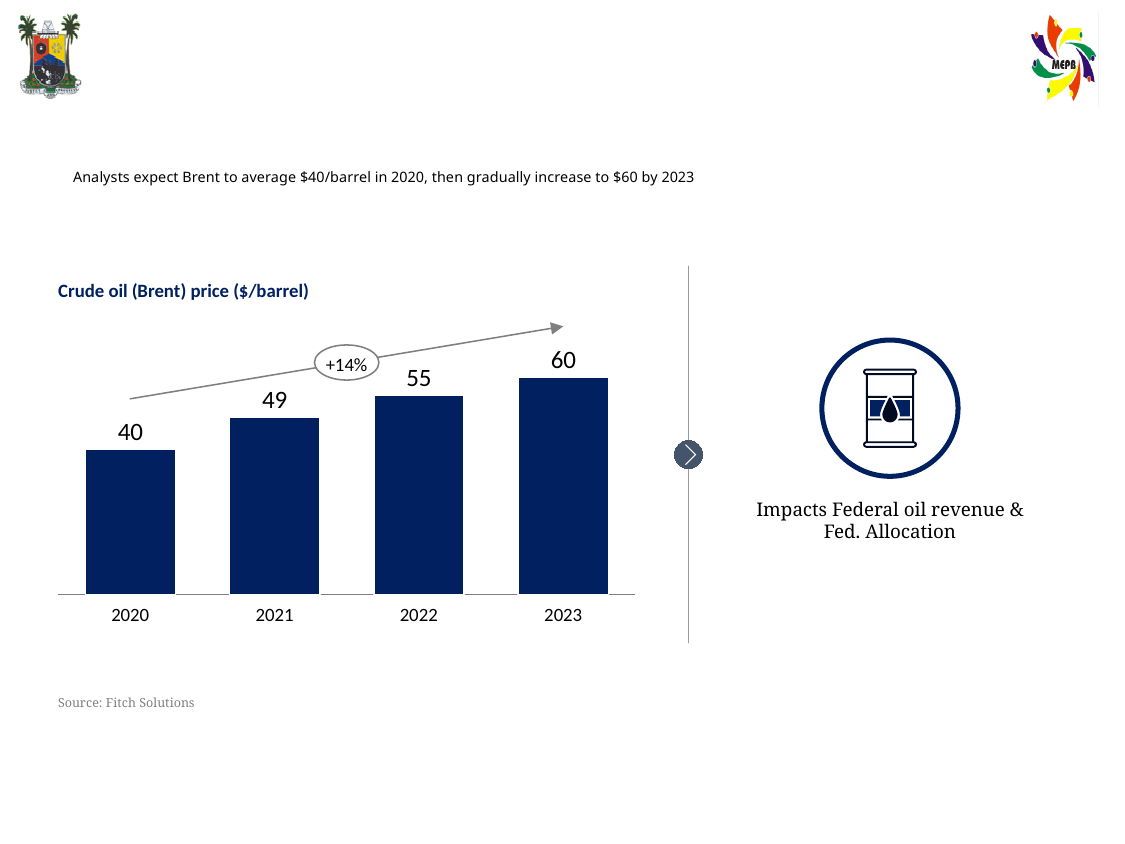
Which year has the lowest crude oil (Brent) price in the chart? 2020 Which year has a higher Brent price, 2021 or 2022? 2022 What kind of chart is used to show the crude oil (Brent) price? Bar chart What is the crude oil (Brent) price shown for 2020? 40 What is the difference between the Brent price in 2023 and in 2020? 20 What is the difference between the Brent price in 2021 and in 2020? 9 Which year has the highest crude oil (Brent) price in the chart? 2023 How many years are shown in the crude oil (Brent) price chart? 4 What is the crude oil (Brent) price shown for 2023? 60 What is the crude oil (Brent) price shown for 2022? 55 What percentage change is annotated on the arrow above the bars? +14% Do the Brent prices rise or fall from 2020 to 2023? Rise